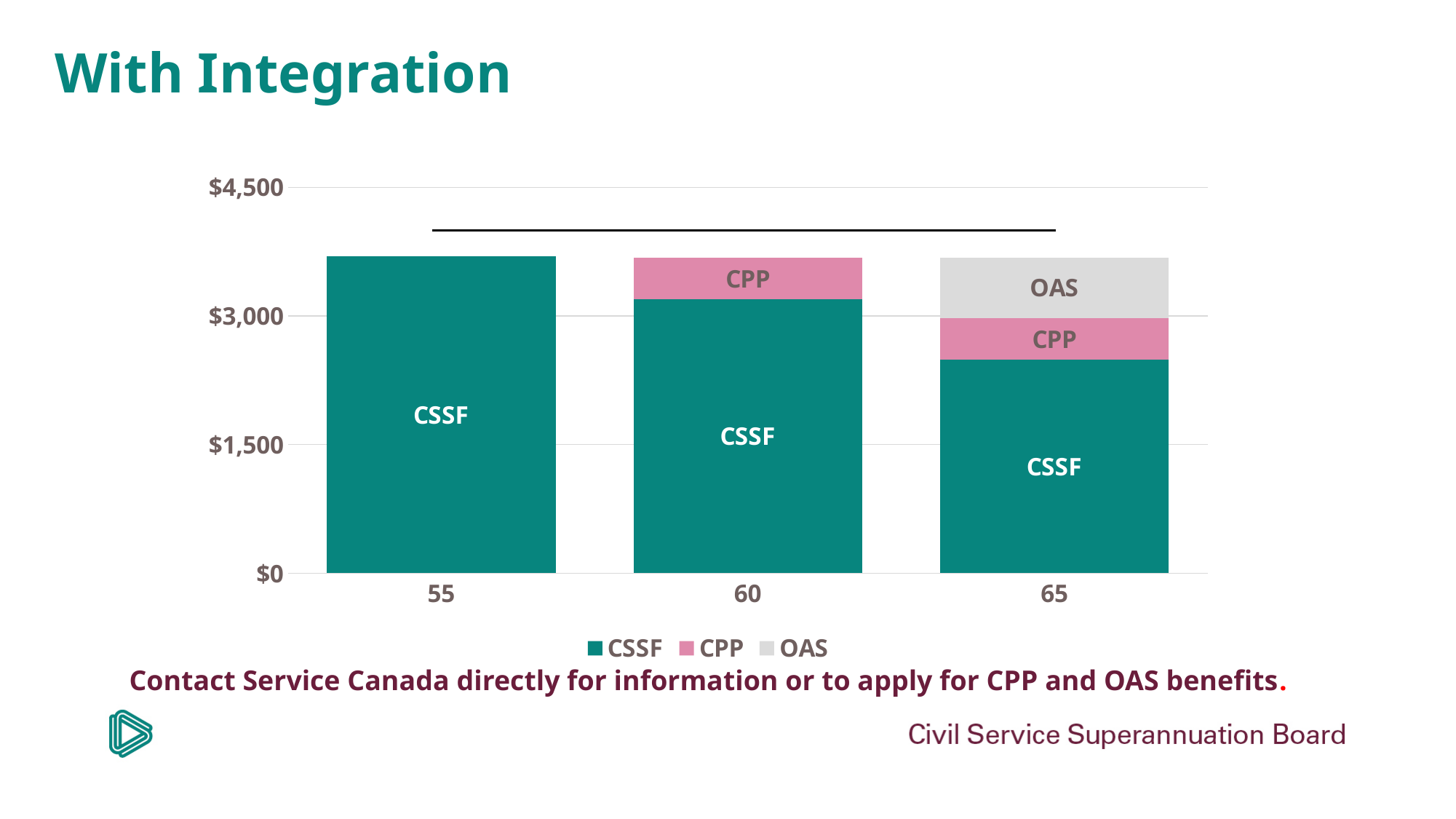
Is the CSSF value for age 65 greater or less than $3,000? less Does the CSSF segment rise or fall as age increases from 55 to 65? fall How many categories are shown on the x axis of the chart? 3 Which age category has the smallest CSSF segment? 65 Which age category has the largest CSSF segment? 55 How many series does the chart legend list? 3 Which is larger, the CSSF value at age 55 or the CSSF value at age 65? age 55 Which series is shown in grey in the chart? OAS Is the CSSF value for age 55 greater or less than $3,000? greater Is the total height of the stacked bar for age 65 greater or less than $3,000? greater What is the title of the slide containing the chart? With Integration What kind of chart is shown on the slide? bar chart